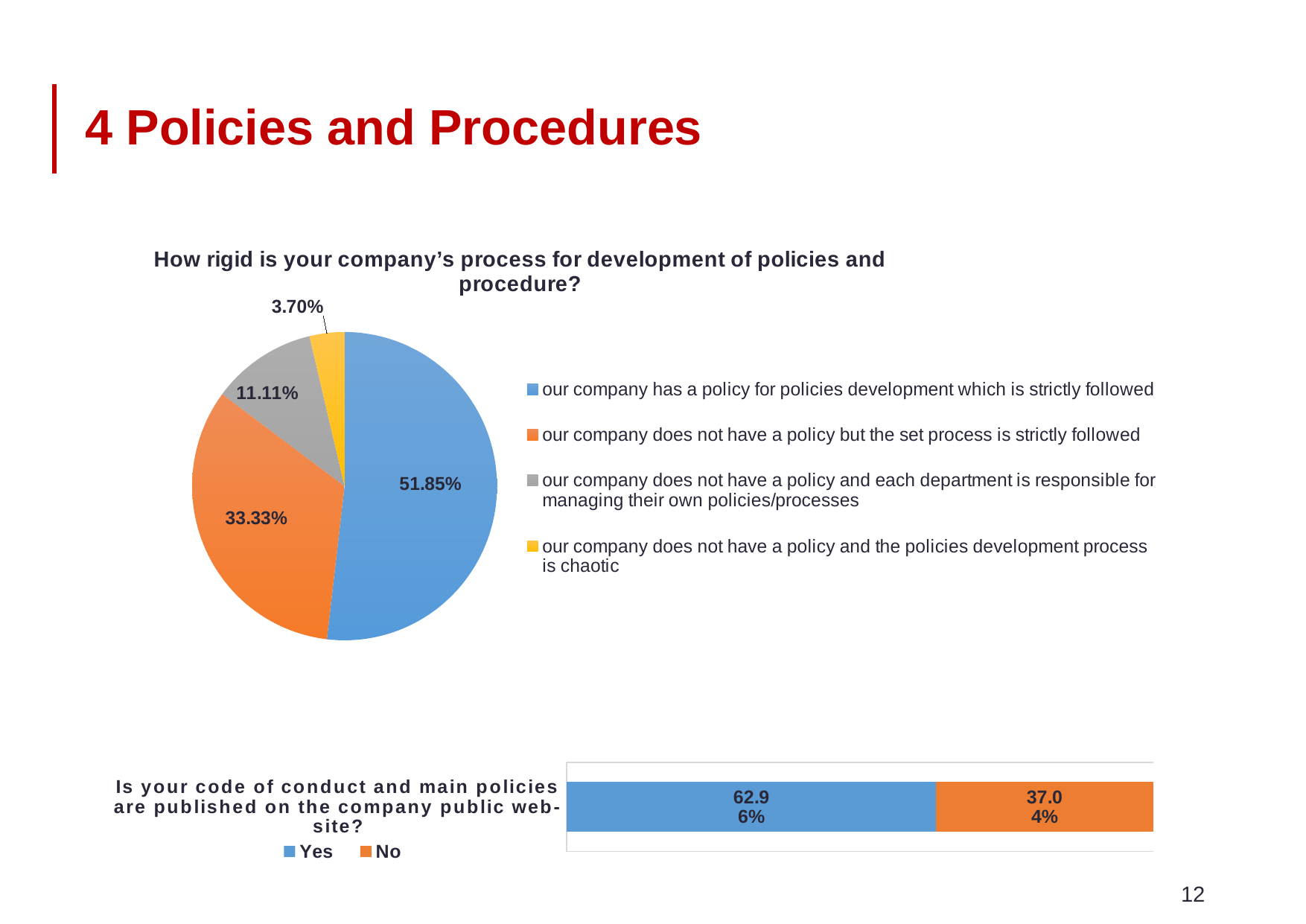
What type of chart is used for the question 'How rigid is your company's process for development of policies and procedure?'? pie chart In the chart 'Is your code of conduct and main policies are published on the company public web-site?', how many series does the legend list? 2 In the pie chart 'How rigid is your company's process for development of policies and procedure?', what share of respondents said the policies development process is chaotic? 3.70% In the pie chart 'How rigid is your company's process for development of policies and procedure?', which response has the smallest share? our company does not have a policy and the policies development process is chaotic In the pie chart 'How rigid is your company's process for development of policies and procedure?', which response has the largest share? our company has a policy for policies development which is strictly followed In the chart 'Is your code of conduct and main policies are published on the company public web-site?', what percentage answered No? 37.04% In the pie chart 'How rigid is your company's process for development of policies and procedure?', what share of respondents said their company has a policy for policies development which is strictly followed? 51.85% In the pie chart 'How rigid is your company's process for development of policies and procedure?', what is the difference in percentage points between the largest slice and the second-largest slice? 18.52 percentage points In the pie chart 'How rigid is your company's process for development of policies and procedure?', what share of respondents said their company does not have a policy but the set process is strictly followed? 33.33% In the pie chart 'How rigid is your company's process for development of policies and procedure?', what share of respondents said each department is responsible for managing their own policies/processes? 11.11% In the chart 'Is your code of conduct and main policies are published on the company public web-site?', what percentage answered Yes? 62.96% In the pie chart 'How rigid is your company's process for development of policies and procedure?', how many response categories are shown? 4